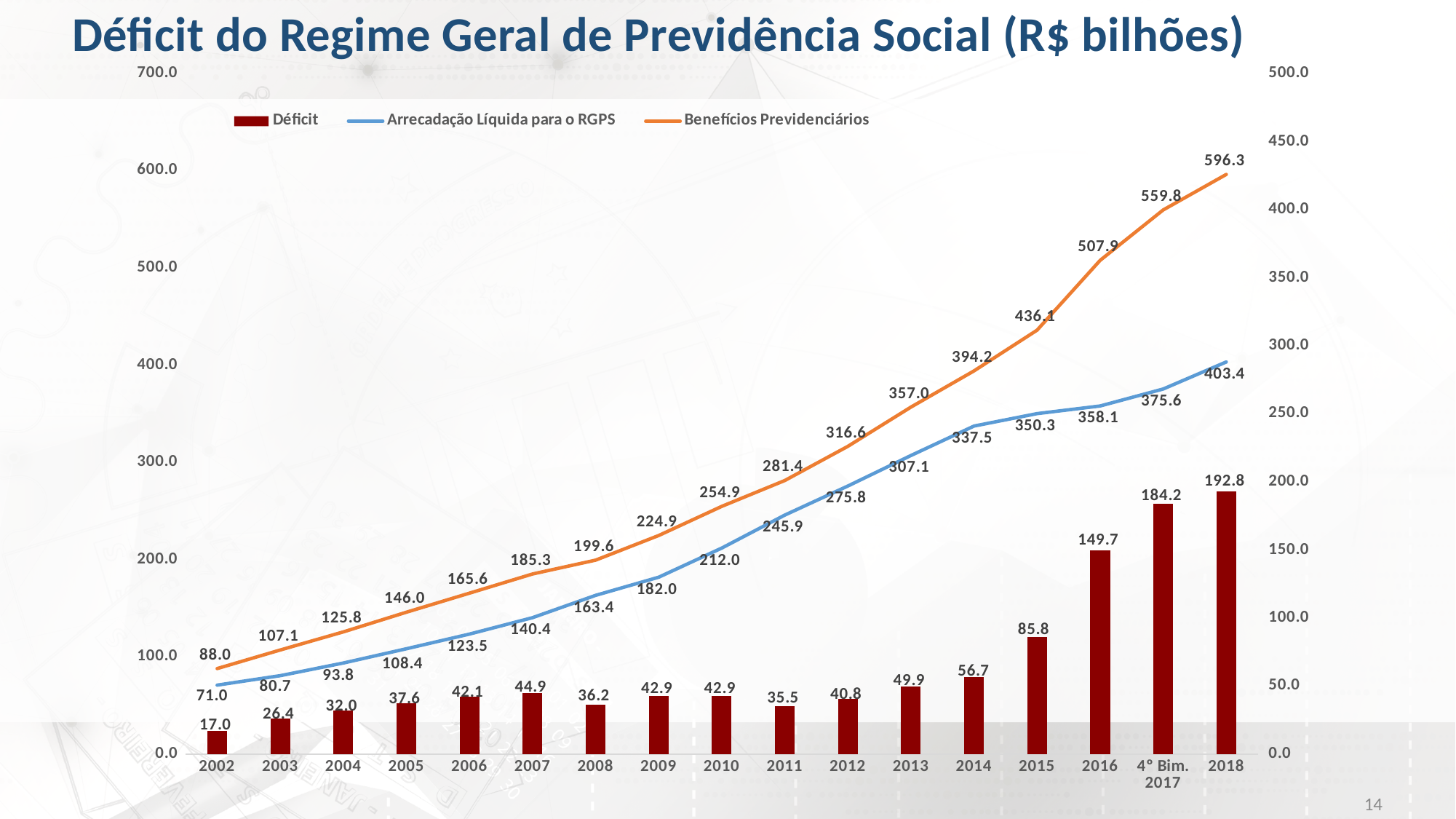
Which is larger in 2008: the Déficit or the Déficit in 2007? 2007 In which year is the Déficit lowest? 2002 How many series does the legend list? 3 Does the Benefícios Previdenciários line rise or fall from 2002 to 2018? Rises What is the Déficit value for 2018? 192.8 What is the difference between Benefícios Previdenciários and Arrecadação Líquida para o RGPS in 2018? 192.9 What colour are the Déficit bars? Dark red What kind of chart is this? Combination bar and line chart Which category has the highest Benefícios Previdenciários value? 2018 How many categories are shown on the x axis? 17 What is the value of Benefícios Previdenciários in 2010? 254.9 What is the value of Arrecadação Líquida para o RGPS in 2014? 337.5